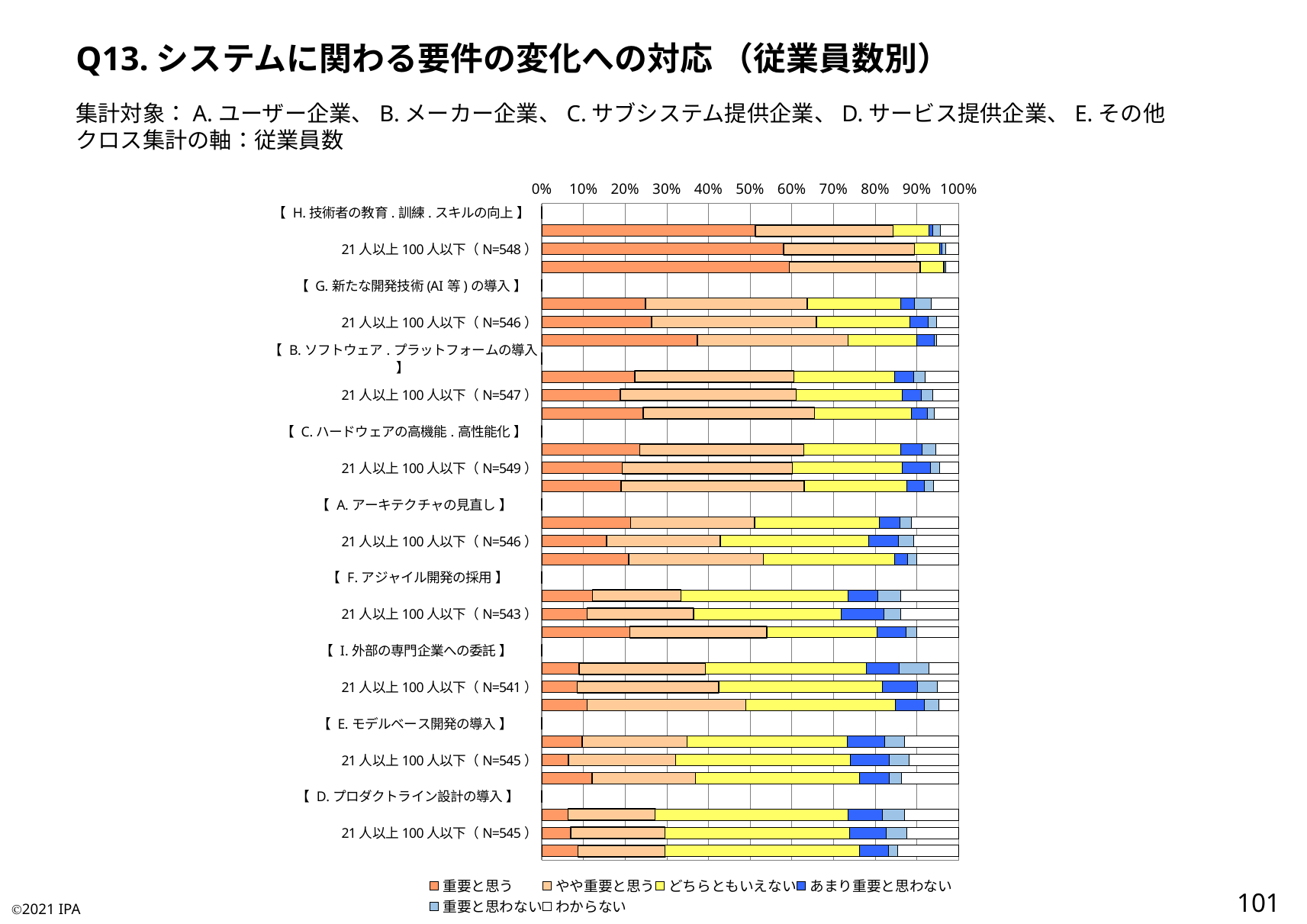
How many bracketed category headings (【 】) are listed down the left side of the chart? 9 How many series does the legend list? 6 What kind of chart is shown on the slide? stacked bar chart Is the 重要と思う share for 21人以上100人以下 (N=545) under 【D. プロダクトライン設計の導入】 greater or less than 10%? less What is the last legend entry (the white series)? わからない Which has the larger 重要と思う share: 21人以上100人以下 under 【H. 技術者の教育.訓練.スキルの向上】 or 21人以上100人以下 under 【D. プロダクトライン設計の導入】? 【H. 技術者の教育.訓練.スキルの向上】 Is the 重要と思う share for 21人以上100人以下 (N=548) under 【H. 技術者の教育.訓練.スキルの向上】 greater or less than 50%? greater Among the 21人以上100人以下 bars, which category heading has the largest 重要と思う share? 【H. 技術者の教育.訓練.スキルの向上】 Is the 重要と思う share for 21人以上100人以下 (N=543) under 【F. アジャイル開発の採用】 greater or less than 20%? less How many bars are plotted in the chart in total? 27 What is the maximum value shown on the horizontal axis? 100% What is the first legend entry (the dark orange series)? 重要と思う